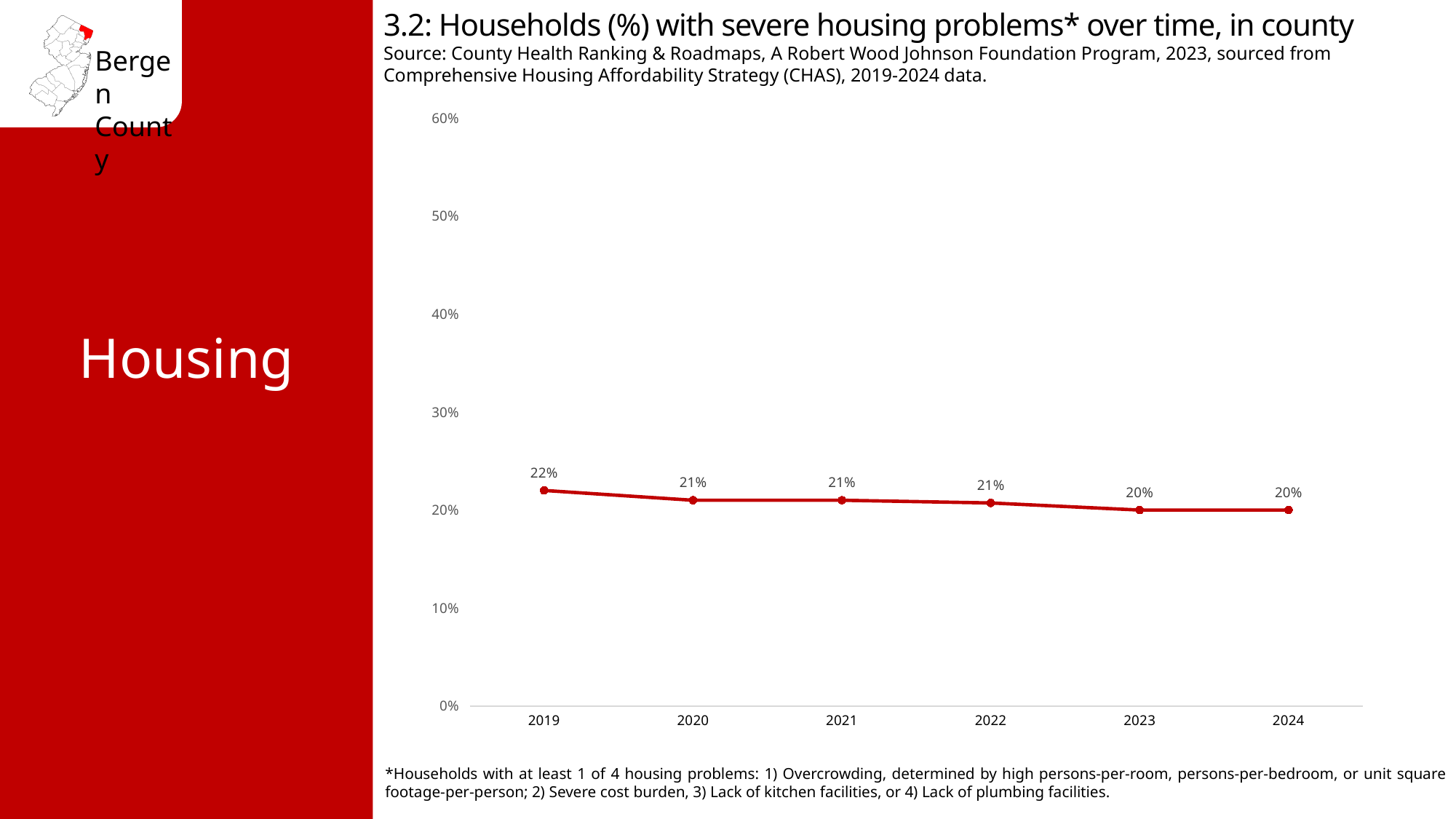
What is the difference between the 2019 value and the 2024 value? 2% What colour is the line on the chart? red Which year has the highest percentage of households with severe housing problems? 2019 What percentage of households had severe housing problems in 2019? 22% Is the value for 2021 greater or less than 30%? less How many years are plotted on the chart? 6 What is the value shown for 2022? 21% Is the value for 2019 greater or less than the value for 2023? greater Do the values rise or fall from 2019 to 2024? fall What kind of chart is shown on the slide? line chart What percentage of households had severe housing problems in 2024? 20% What is the title of the chart? 3.2: Households (%) with severe housing problems* over time, in county